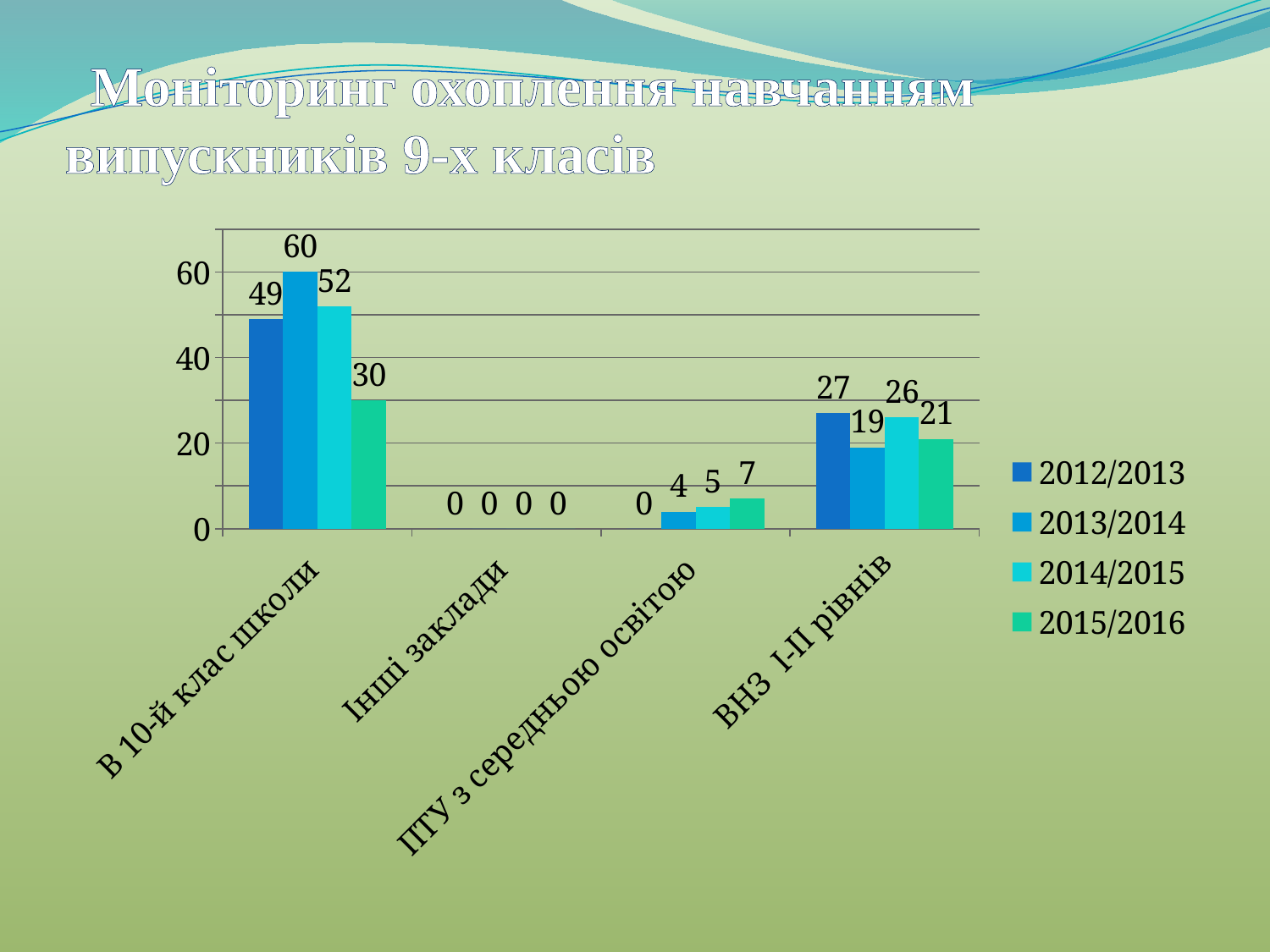
Which series has the lowest value for 'ВНЗ І-ІІ рівнів'? 2013/2014 Which is larger for 'ВНЗ І-ІІ рівнів': the 2012/2013 value or the 2014/2015 value? 2012/2013 How many series does the legend list? 4 What kind of chart is shown on the slide? bar chart How many categories are shown on the x axis? 4 What is the difference between the 2013/2014 and 2015/2016 values for 'В 10-й клас школи'? 30 Which category has the highest value in the 2012/2013 series? В 10-й клас школи What is the value for 'ПТУ з середньою освітою' in the 2014/2015 series? 5 Do the values for 'ПТУ з середньою освітою' rise or fall from 2012/2013 to 2015/2016? rise What is the title of the slide? Моніторинг охоплення навчанням випускників 9-х класів What is the value for 'В 10-й клас школи' in the 2013/2014 series? 60 What is the value for 'ВНЗ І-ІІ рівнів' in the 2015/2016 series? 21